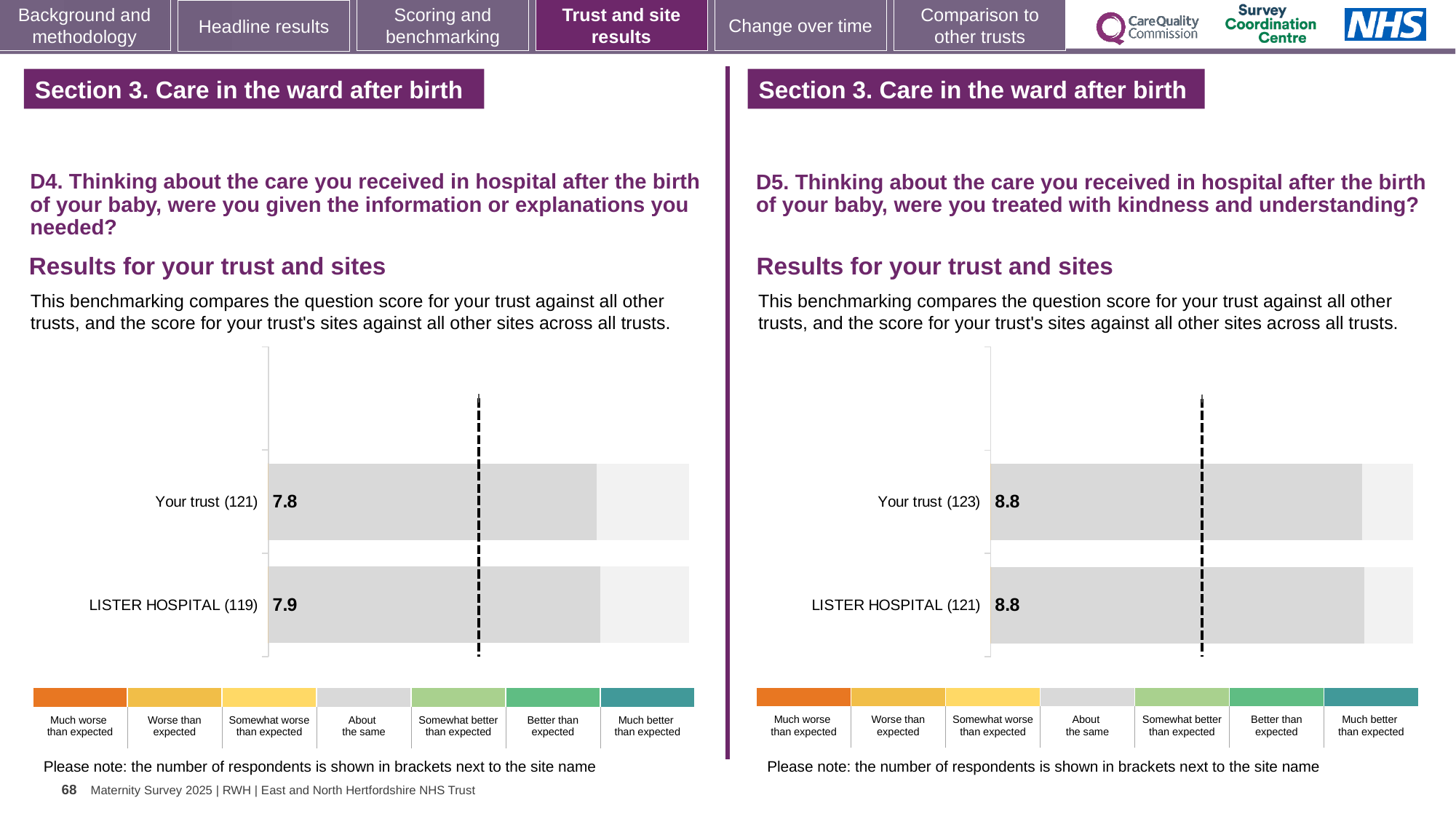
In the D4 chart on the left, what is the score for LISTER HOSPITAL (119)? 7.9 How many categories does the colour legend below the D5 chart on the right list? 7 In the D5 chart on the right, what is the difference between the Your trust score and the LISTER HOSPITAL score? 0 In the D4 chart on the left, which has the higher score, Your trust or LISTER HOSPITAL? LISTER HOSPITAL How many bars are plotted in the D4 chart on the left? 2 In the D5 chart on the right, what is the score for Your trust (123)? 8.8 In the D5 chart on the right, what is the score for LISTER HOSPITAL (121)? 8.8 In the D4 chart on the left, what is the score for Your trust (121)? 7.8 In the D4 chart on the left, what is the difference between the LISTER HOSPITAL score and the Your trust score? 0.1 What type of chart is used in the D5 chart on the right? Bar chart How many bars are plotted in the D5 chart on the right? 2 In the D4 chart on the left, how many respondents are shown in brackets for LISTER HOSPITAL? 119